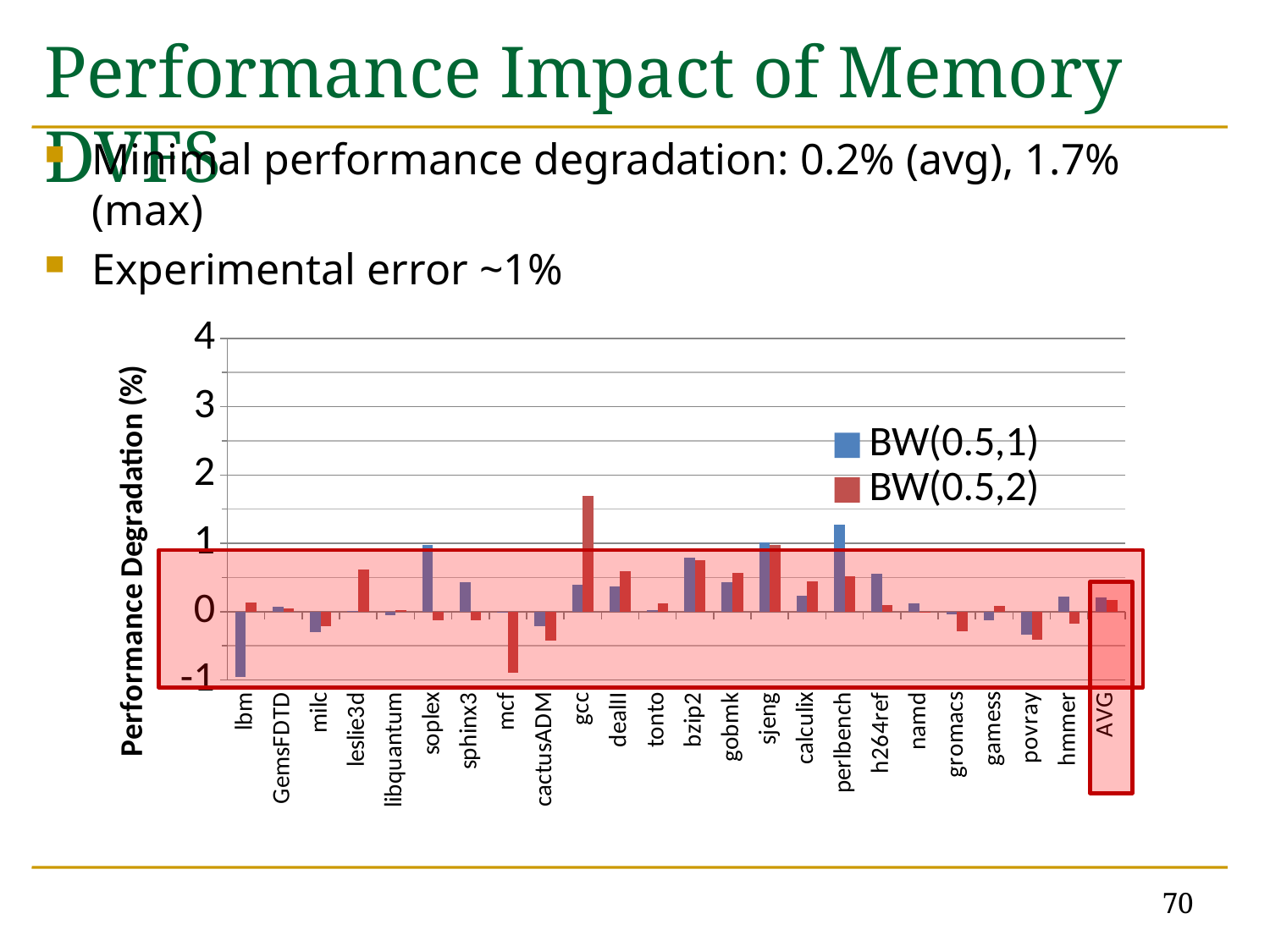
Which category has the highest BW(0.5,1) value in the chart? perlbench How many categories are shown along the x axis of the chart? 24 What kind of chart is shown on the slide? bar chart Is the BW(0.5,2) value for gcc greater or less than 1? greater How many series does the chart's legend list? 2 What is the title of the chart's vertical axis? Performance Degradation (%) Which category has the lowest BW(0.5,1) value in the chart? lbm Which category has the lowest BW(0.5,2) value in the chart? mcf Is the BW(0.5,1) value for lbm greater or less than 0? less What are the two series names listed in the chart's legend? BW(0.5,1) and BW(0.5,2) Which category has the highest BW(0.5,2) value in the chart? gcc For gcc, which series has the larger value, BW(0.5,1) or BW(0.5,2)? BW(0.5,2)